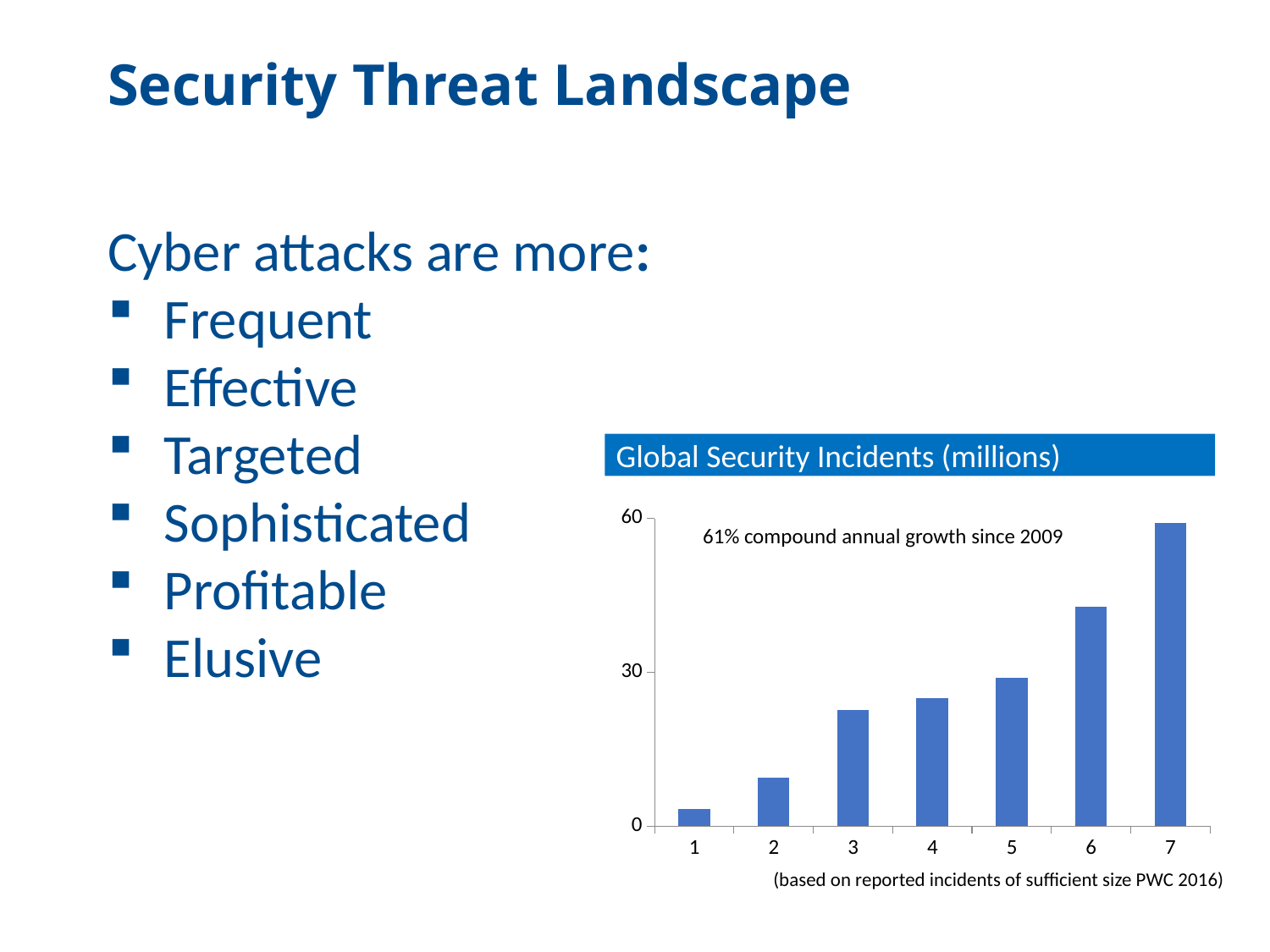
Is the value for category 3 greater or less than 30? less Do the values rise or fall from category 1 to category 7? rise Is the value for category 6 greater or less than 30? greater Which category has the lowest bar? 1 Is the value for category 1 greater or less than 30? less What kind of chart is shown on the slide? bar chart Which is larger, the value for category 6 or the value for category 3? 6 What compound annual growth rate since 2009 is stated on the chart? 61% How many bars are plotted in the chart? 7 What is the title of the chart? Global Security Incidents (millions) Which category has the highest bar? 7